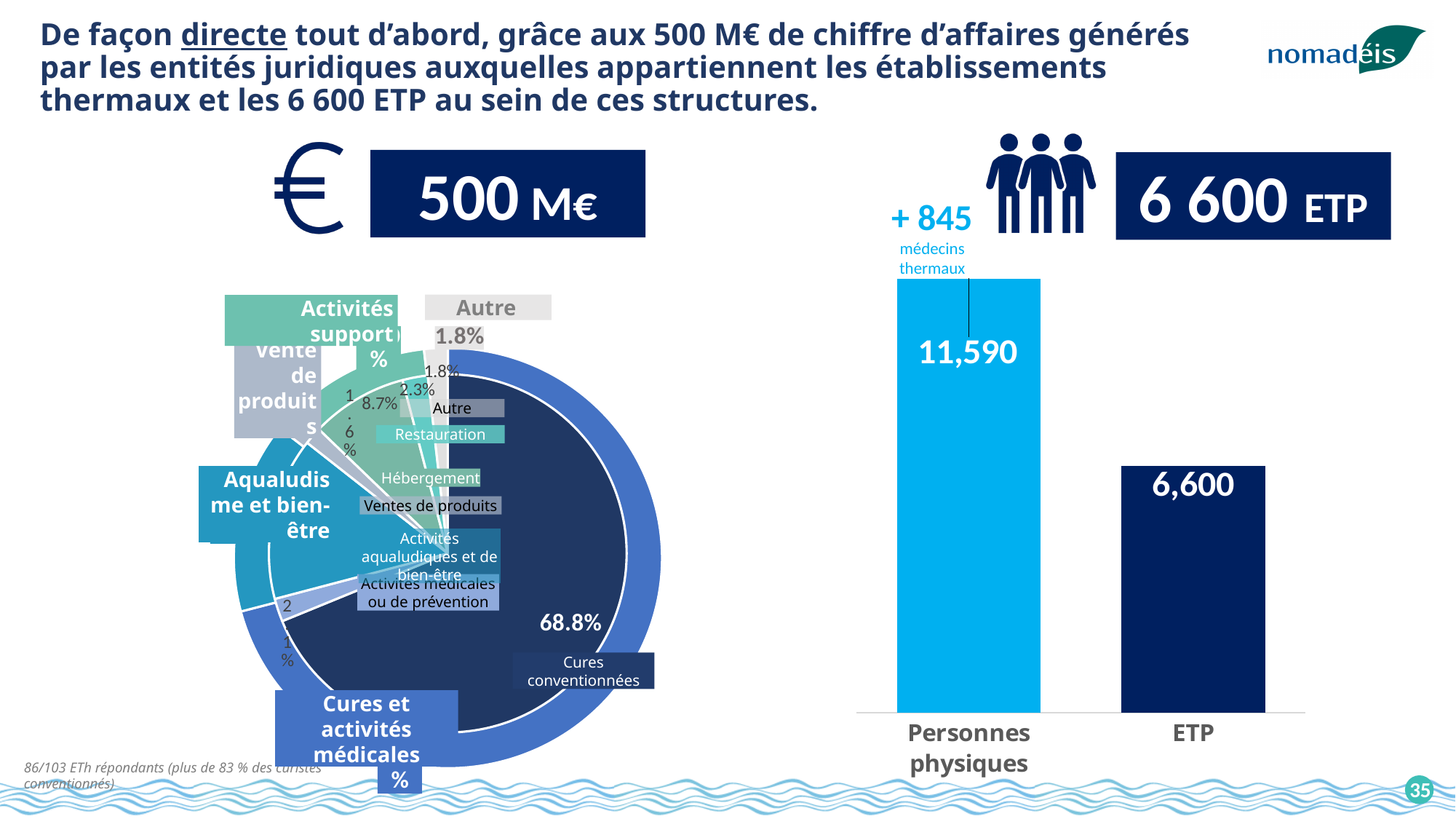
In the bar chart on the right, which category has the higher value? Personnes physiques In the bar chart on the right, how many bars are plotted? 2 In the pie chart on the left, what share is shown for Autre? 1.8% In the bar chart on the right, which category has the lower value? ETP In the bar chart on the right, what is the difference between the Personnes physiques value and the ETP value? 4,990 In the pie chart on the left, which category has the largest slice? Cures conventionnées What kind of chart is shown on the left side of the slide? Pie chart In the bar chart on the right, what is the value for ETP? 6,600 What kind of chart is shown on the right side of the slide? Bar chart In the bar chart on the right, what is the value for Personnes physiques? 11,590 In the pie chart on the left, what share is shown for Cures conventionnées? 68.8%